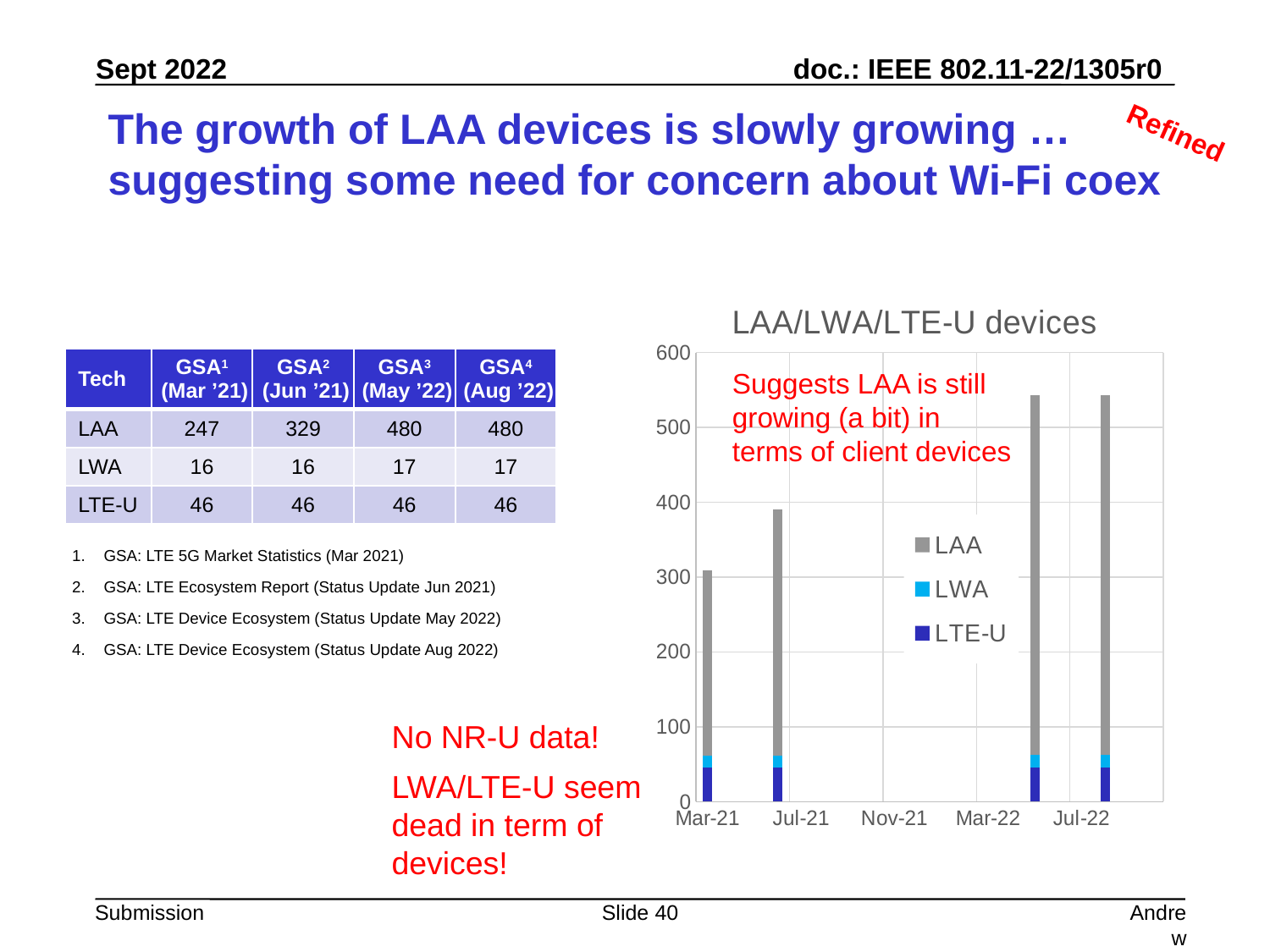
Which bar in the chart is the shortest overall? Mar-21 Is the total height of the second bar (near Jul-21) greater or less than 300? greater Do the bar totals rise or fall from left to right along the x axis? Rise Is the total height of the first bar (Mar-21) greater or less than 400? less Is the total height of the bar near Mar-22 greater or less than 500? greater What is the title of the chart? LAA/LWA/LTE-U devices Which series makes up the largest segment of each stacked bar? LAA How many bars are plotted in the chart? 4 What kind of chart is shown on the slide? Stacked bar chart Which series are listed in the chart legend? LAA, LWA, LTE-U How many series does the chart legend list? 3 Which is taller overall, the first bar (Mar-21) or the second bar (near Jul-21)? The second bar (near Jul-21)